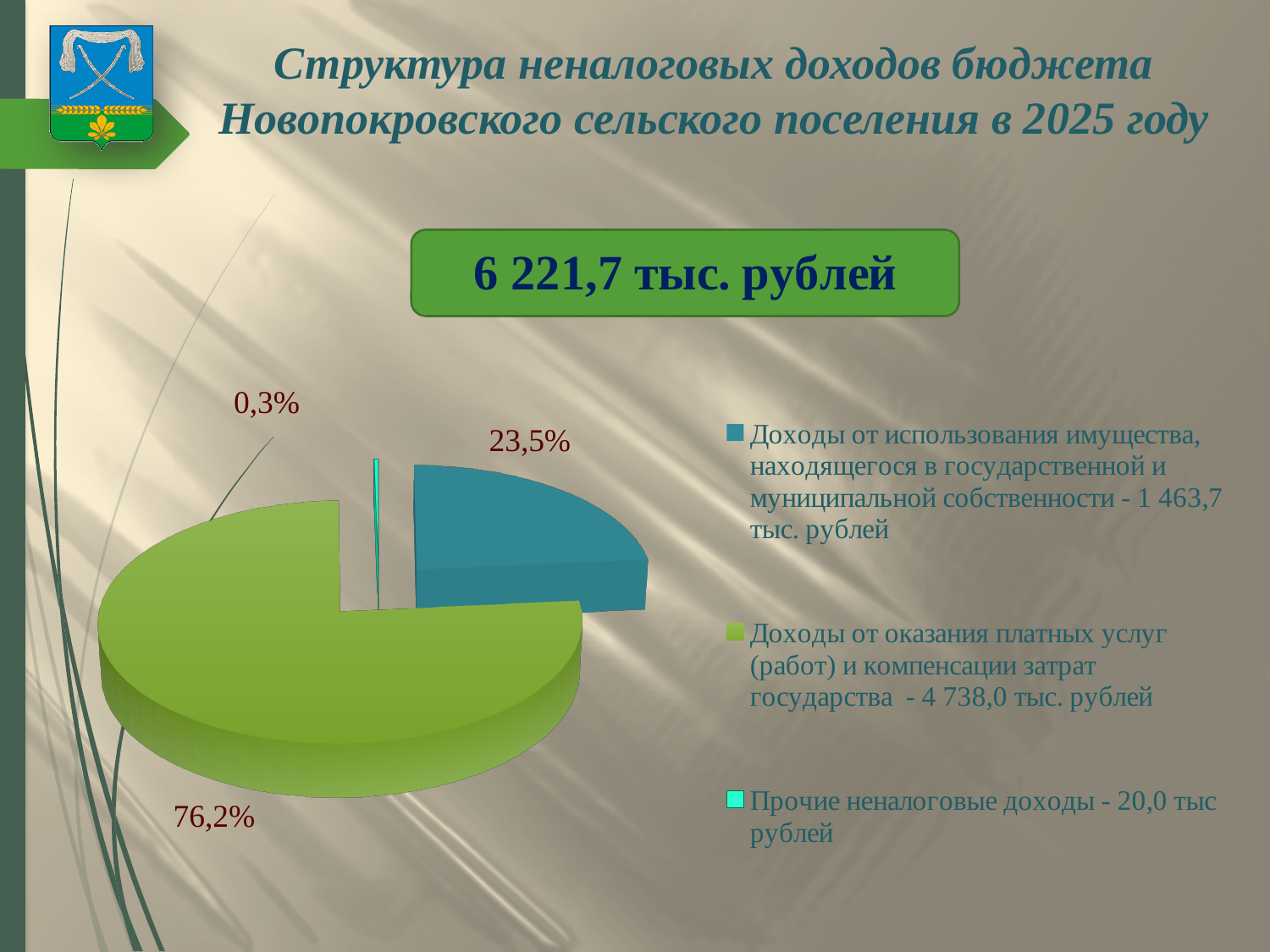
According to the legend, what is the value for 'Прочие неналоговые доходы'? 20,0 тыс рублей What type of chart is shown on the slide? pie chart What total amount of non-tax budget revenue is shown in the green box on the slide? 6 221,7 тыс. рублей What is the difference in percentage points between the 76,2% slice and the 23,5% slice? 52,7 How many entries does the legend list? 3 What share of the pie is labelled for 'Прочие неналоговые доходы'? 0,3% What share of the pie is labelled for 'Доходы от использования имущества, находящегося в государственной и муниципальной собственности'? 23,5% According to the legend, what is the value for 'Доходы от оказания платных услуг (работ) и компенсации затрат государства'? 4 738,0 тыс. рублей What share of the pie is labelled for 'Доходы от оказания платных услуг (работ) и компенсации затрат государства'? 76,2% Which category has the smallest slice of the pie? Прочие неналоговые доходы Which category has the largest slice of the pie? Доходы от оказания платных услуг (работ) и компенсации затрат государства How many slices does the pie chart have? 3